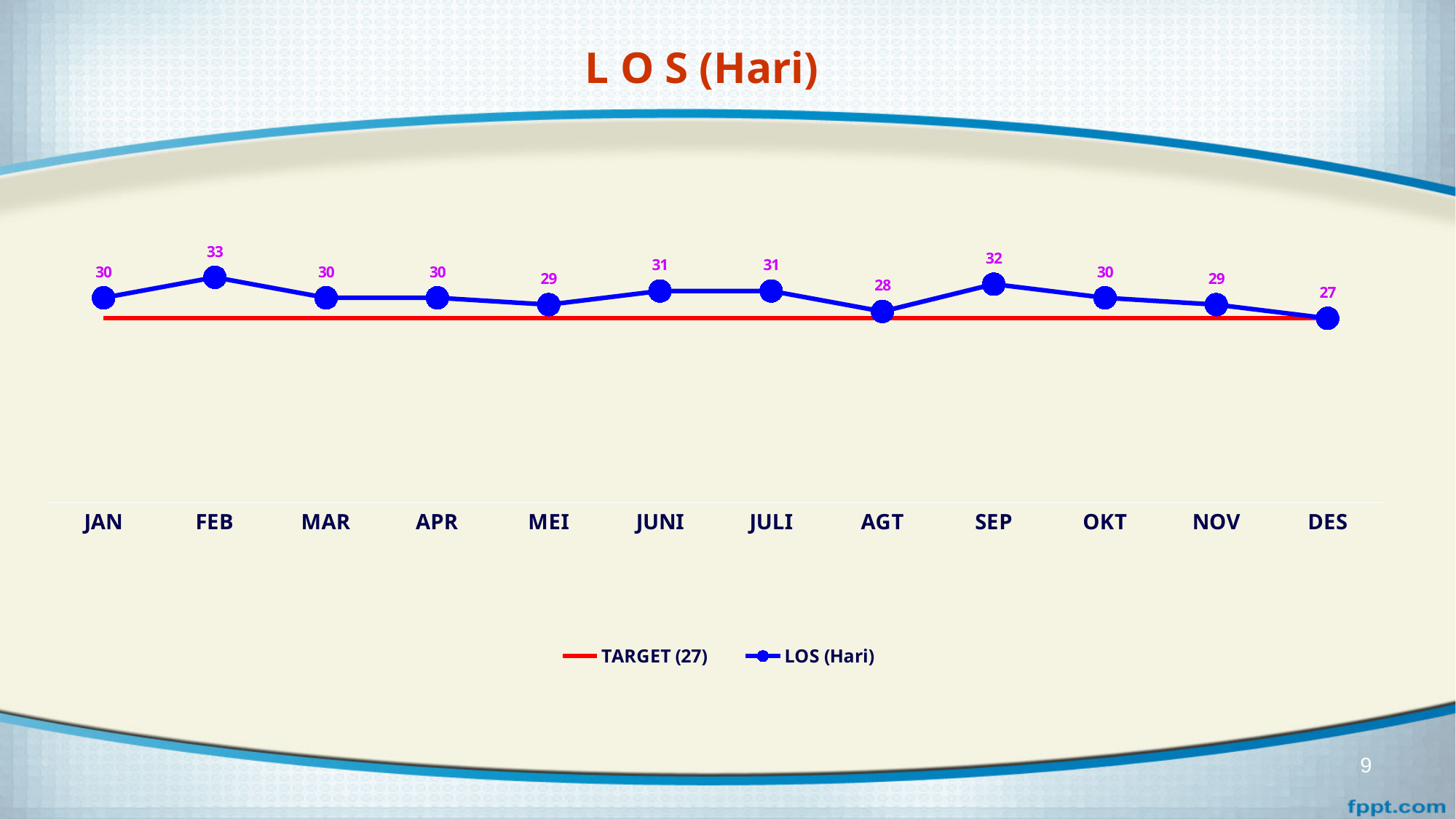
What kind of chart is shown on the slide? Line chart What is the LOS (Hari) value for DES? 27 What is the target value shown in the legend? 27 Which month has the lowest LOS (Hari) value? DES Which month has the highest LOS (Hari) value? FEB How many months are plotted on the x axis? 12 How many series does the legend list? 2 What is the LOS (Hari) value for SEP? 32 What is the LOS (Hari) value for FEB? 33 Which is larger, the LOS (Hari) value for JUNI or for MEI? JUNI What is the difference between the LOS (Hari) values for FEB and AGT? 5 What colour is the TARGET (27) line? Red